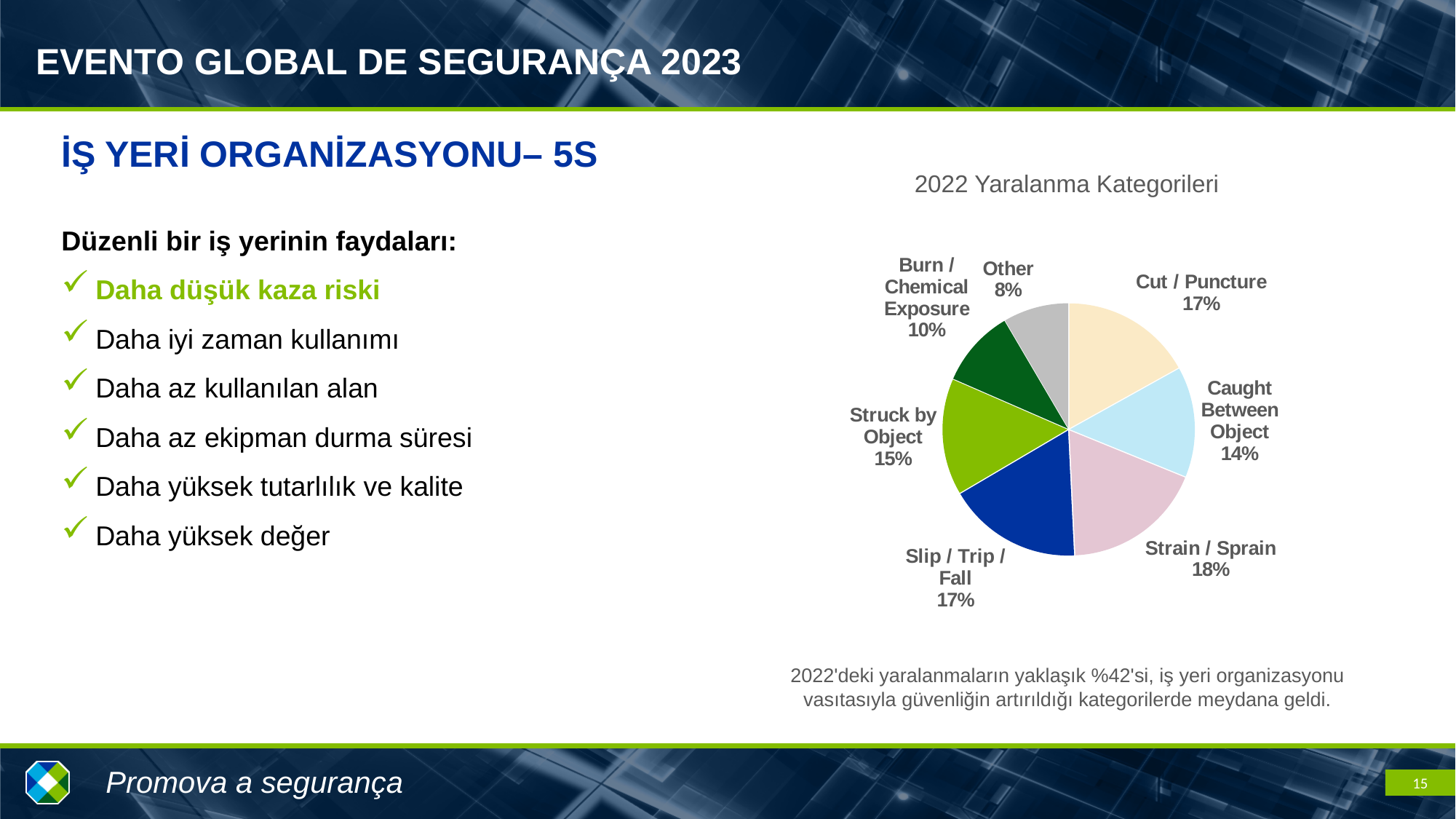
What is the value shown for Slip / Trip / Fall? 17% Which category has the smallest share of the pie? Other What is the difference between the shares of Strain / Sprain and Other? 10% What type of chart is shown on the slide? pie chart What is the title of the chart? 2022 Yaralanma Kategorileri Which is larger, Struck by Object or Caught Between Object? Struck by Object What is the combined share of Struck by Object and Slip / Trip / Fall? 32% How many categories are shown in the pie chart? 7 Which category has the largest share of the pie? Strain / Sprain What share of the pie does Strain / Sprain represent? 18% What is the value shown for Burn / Chemical Exposure? 10% What is the value shown for Cut / Puncture? 17%